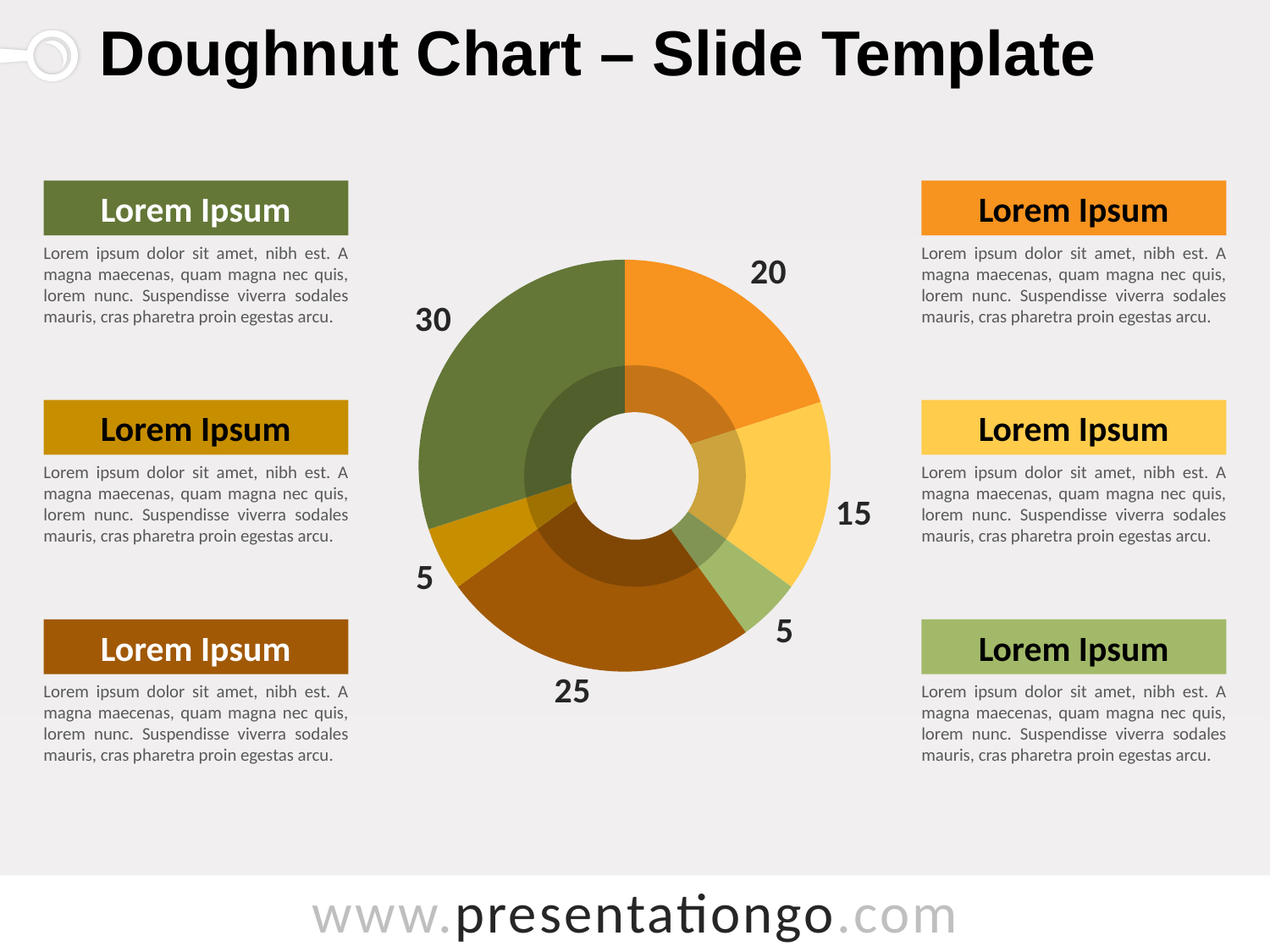
How many slices does the doughnut chart have? 6 How many slices of the doughnut chart have the value 5? 2 What is the difference between the largest slice (30) and the orange slice (20)? 10 What is the total of all the values shown on the doughnut chart? 100 What kind of chart is shown on the slide? doughnut chart What is the value of the yellow slice of the doughnut chart? 15 Which slice is larger, the orange slice or the yellow slice? the orange slice What is the largest value shown on the doughnut chart? 30 What share of the whole doughnut does the slice labelled 25 represent? 25% What is the smallest value shown on the doughnut chart? 5 What is the value of the orange slice of the doughnut chart? 20 What is the value of the brown slice at the bottom of the doughnut chart? 25